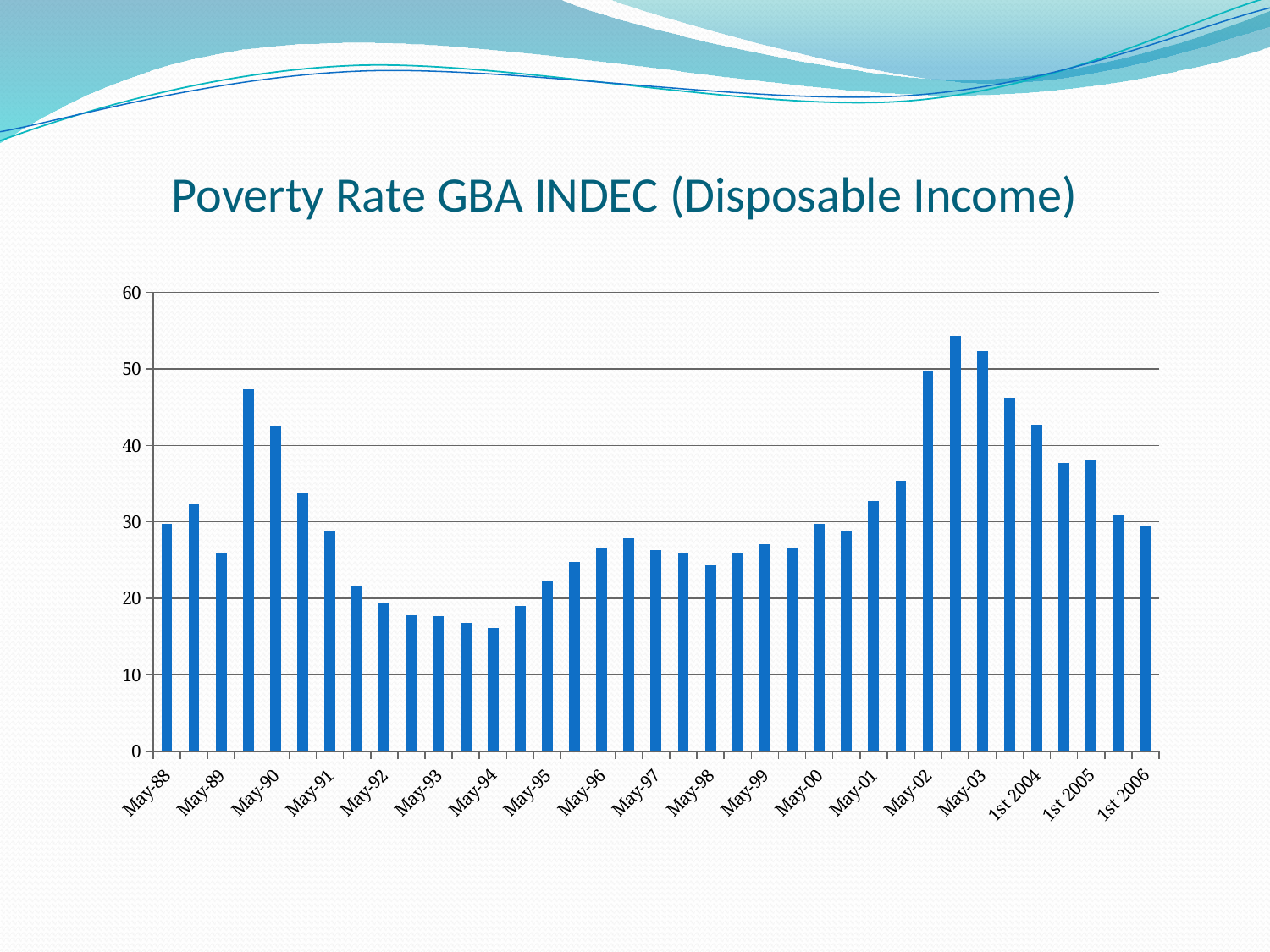
Is the value for May-94 greater or less than 20? less Is the value for 1st 2005 greater or less than 40? less Which is larger, the value for May-03 or the value for May-96? May-03 Do the values rise or fall from May-90 to May-94? fall Which is larger, the value for May-90 or the value for May-89? May-90 Is the value for 1st 2004 greater or less than 40? greater What is the title of the chart? Poverty Rate GBA INDEC (Disposable Income) Do the values rise or fall from May-03 to 1st 2006? fall What kind of chart is shown on the slide? bar chart